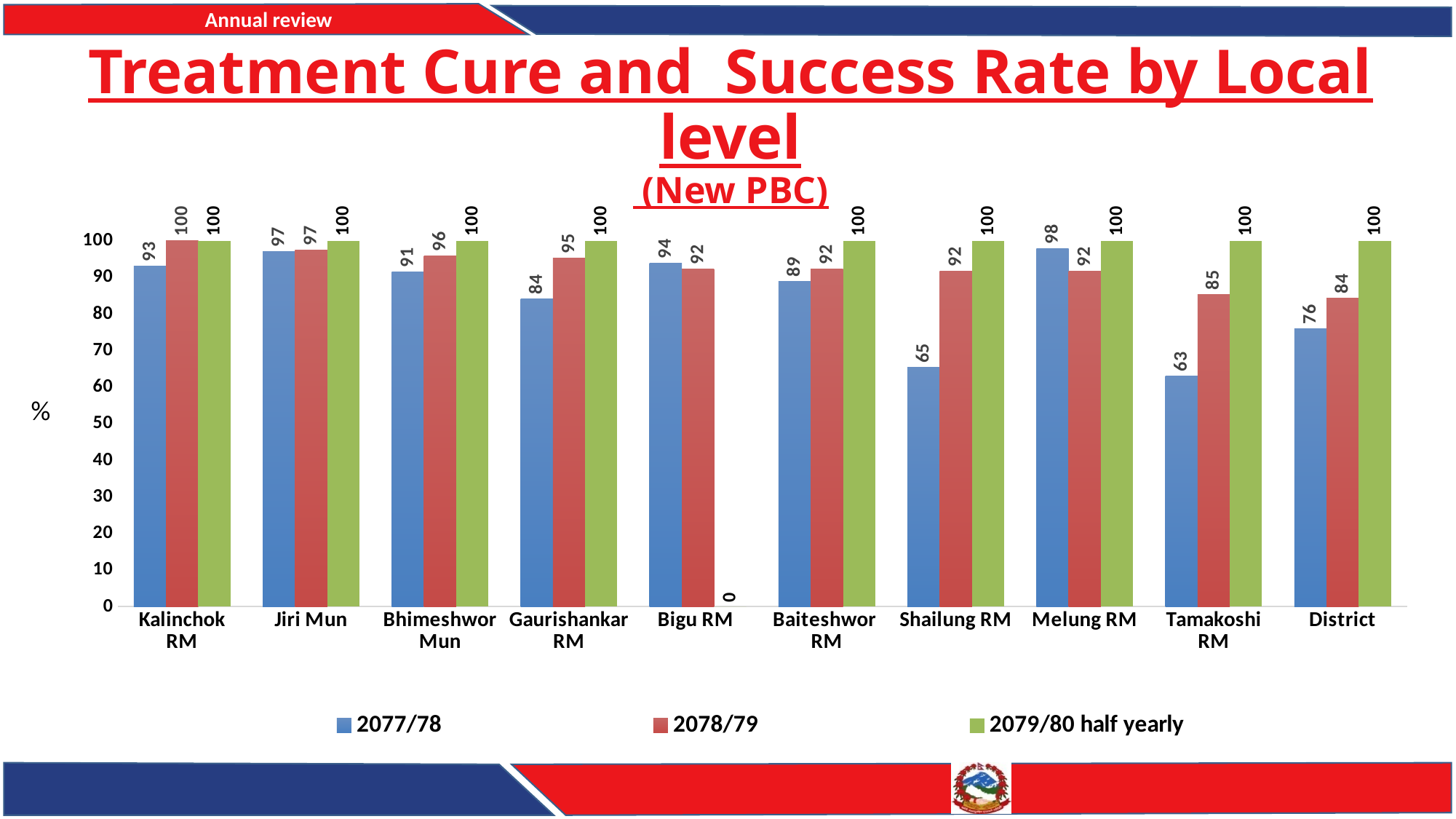
Which is larger for Bigu RM, the 2077/78 value or the 2078/79 value? 2077/78 What is the 2077/78 value for Shailung RM? 65 What is the 2078/79 value for Tamakoshi RM? 85 Which local level has the lowest 2077/78 value? Tamakoshi RM How many series does the legend list? 3 What is the 2079/80 half yearly value for Bigu RM? 0 Which series is shown in green in the legend? 2079/80 half yearly How many local levels are shown on the x axis? 10 What is the difference between the 2078/79 and 2077/78 values for Shailung RM? 27 What kind of chart is shown on the slide? Bar chart Which local level has the highest 2077/78 value? Melung RM What is the 2077/78 value for District? 76